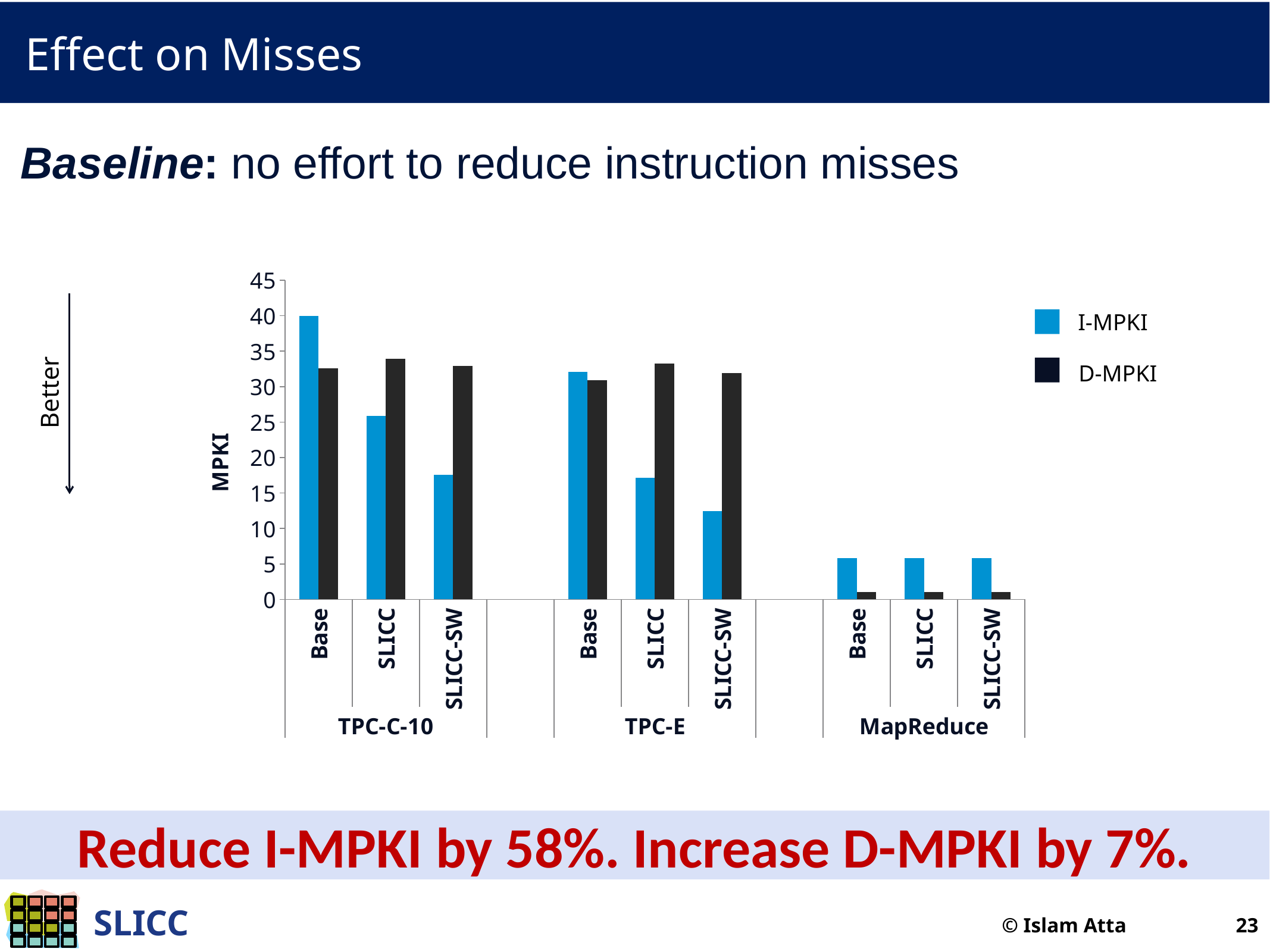
What are the two series named in the legend? I-MPKI and D-MPKI How many configurations are shown within each workload group? 3 For TPC-E, which is larger: the I-MPKI for Base or the I-MPKI for SLICC? Base How many series does the legend list? 2 Which workload group has the lowest D-MPKI values? MapReduce Within the TPC-C-10 group, does I-MPKI rise or fall going from Base to SLICC to SLICC-SW? fall What is the label on the y axis? MPKI Which bar has the highest I-MPKI value in the chart? TPC-C-10 Base Is the I-MPKI value for TPC-E SLICC-SW greater or less than 15? less Is the I-MPKI value for TPC-C-10 Base greater or less than 35? greater What kind of chart is shown on the slide? bar chart How many workload groups are shown along the x axis? 3